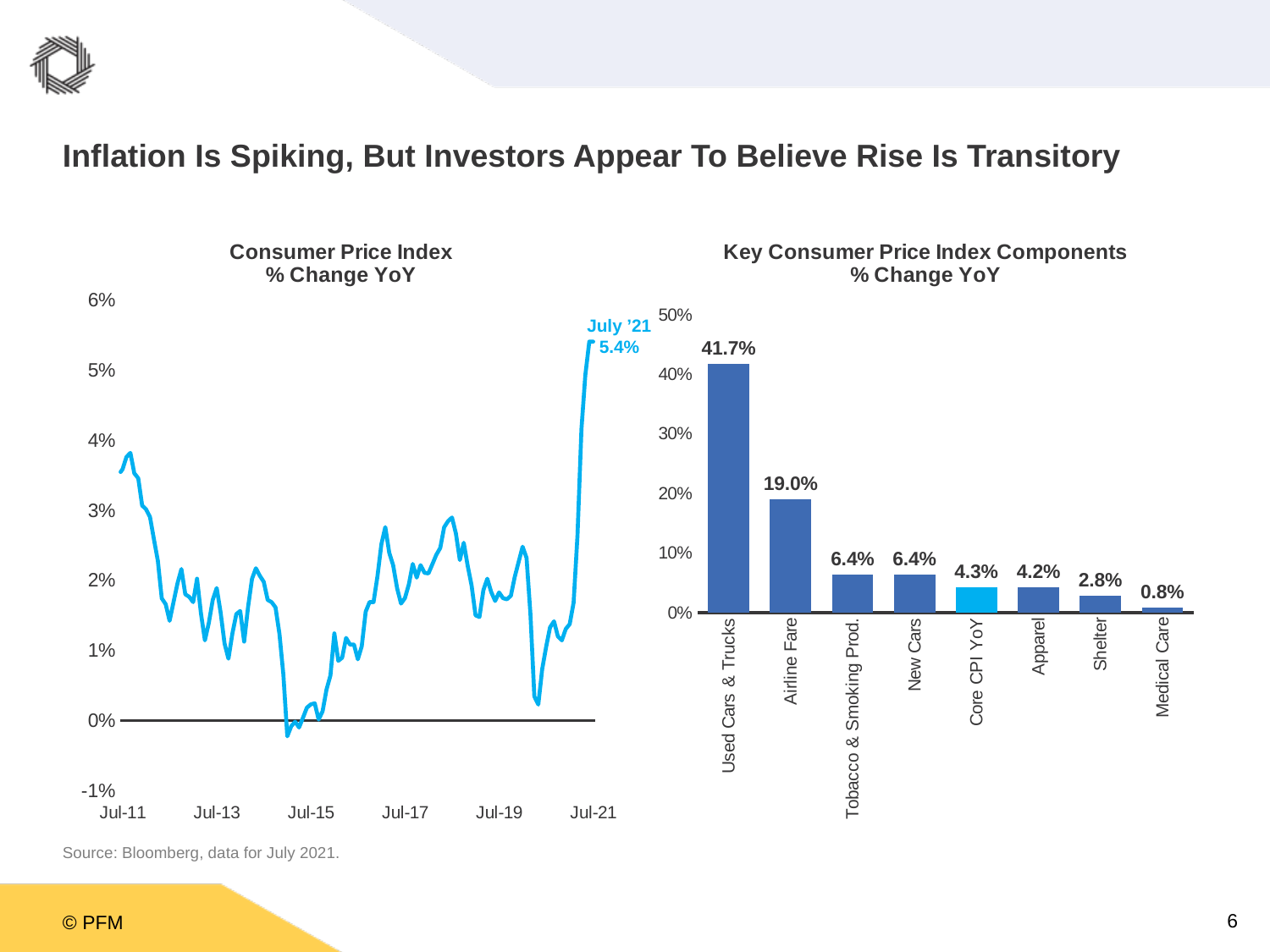
In the 'Key Consumer Price Index Components % Change YoY' chart, what is the value for Core CPI YoY? 4.3% In the 'Key Consumer Price Index Components % Change YoY' chart, what is the value for Used Cars & Trucks? 41.7% In the 'Key Consumer Price Index Components % Change YoY' chart, which category has the lowest value? Medical Care In the 'Consumer Price Index % Change YoY' chart, what is the value labeled for July '21? 5.4% In the 'Key Consumer Price Index Components % Change YoY' chart, which bar is shown in a different (light blue) colour from the others? Core CPI YoY In the 'Key Consumer Price Index Components % Change YoY' chart, which category has the highest value? Used Cars & Trucks In the 'Key Consumer Price Index Components % Change YoY' chart, what is the difference between Used Cars & Trucks and Airline Fare? 22.7% How many categories are shown in the 'Key Consumer Price Index Components % Change YoY' chart? 8 In the 'Key Consumer Price Index Components % Change YoY' chart, what is the value for Airline Fare? 19.0% What kind of chart is the 'Key Consumer Price Index Components % Change YoY' chart? Bar chart In the 'Key Consumer Price Index Components % Change YoY' chart, which is larger, Apparel or Shelter? Apparel What kind of chart is the 'Consumer Price Index % Change YoY' chart? Line chart